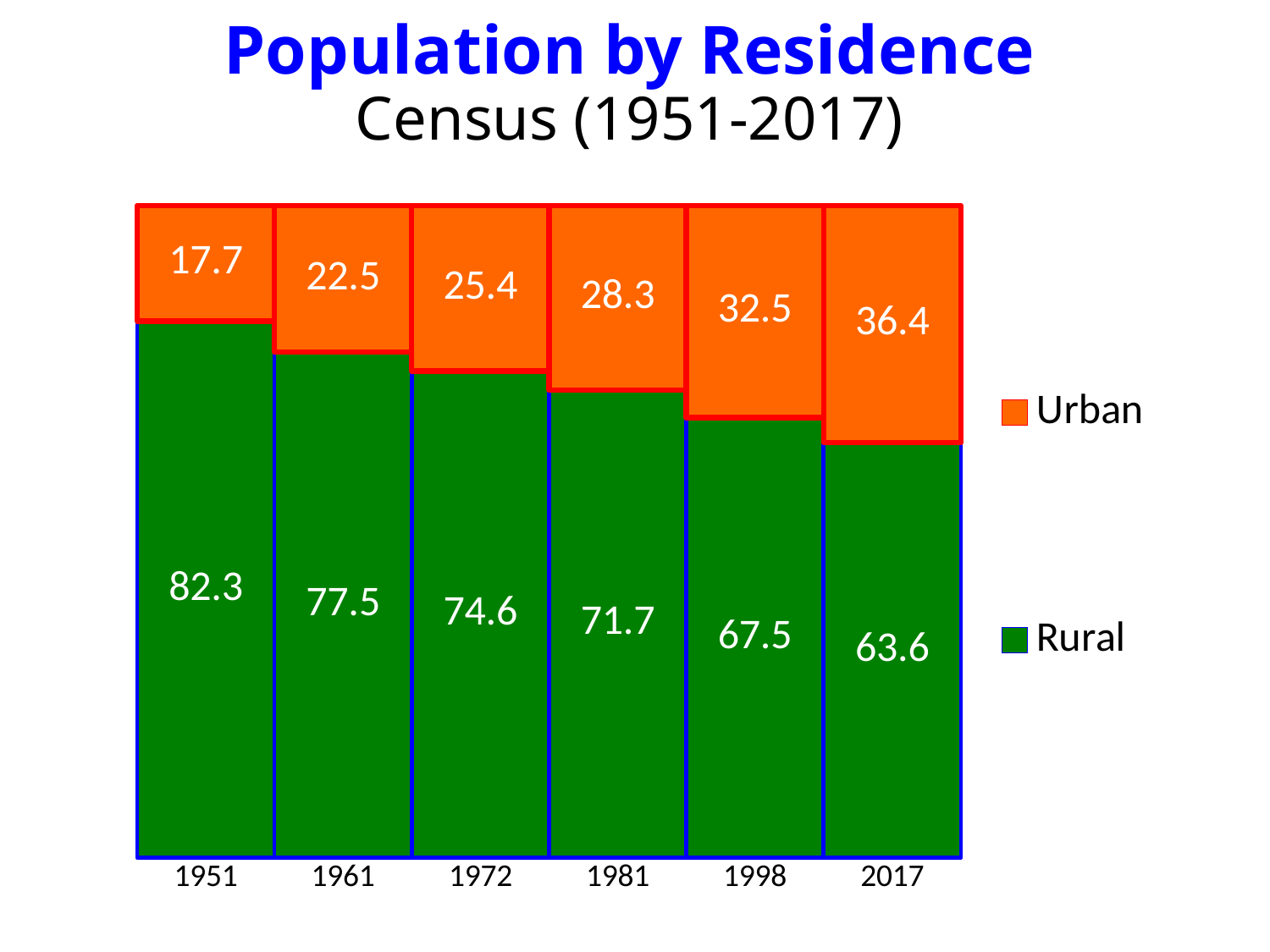
How many series does the legend list? 2 What is the difference between the Urban values for 2017 and 1951? 18.7 Which is larger, the Rural value for 1972 or the Rural value for 1998? 1972 How many years are shown on the x axis? 6 Do the Urban values rise or fall from 1951 to 2017? Rise Which year has the highest Rural value? 1951 What kind of chart is shown? Stacked bar chart What is the total of the stacked bar for 1961? 100 Which year has the lowest Urban value? 1951 What is the Urban value for 1951? 17.7 What is the Urban value for 1981? 28.3 What is the Rural value for 2017? 63.6